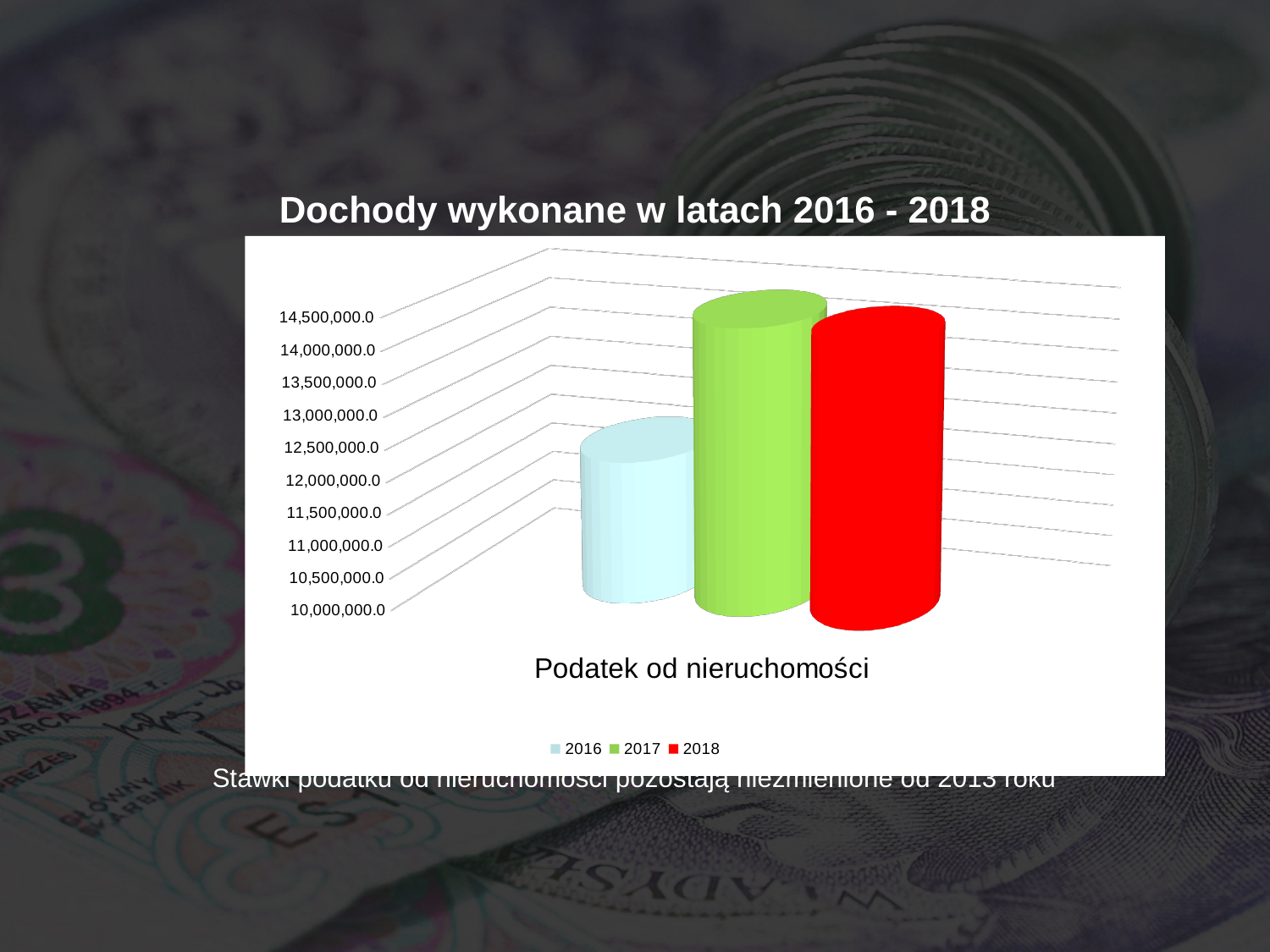
Is the value for 2018 greater or less than 12,500,000.0? greater Is the value for 2016 greater or less than 11,000,000.0? greater How many categories are shown on the x axis? 1 Which year has the lowest value for Podatek od nieruchomości? 2016 Which series is shown in red in the legend? 2018 Which is larger for Podatek od nieruchomości, the value for 2018 or the value for 2016? 2018 What kind of chart is shown on the slide? bar chart Is the value for 2017 greater or less than 13,000,000.0? greater Which is larger for Podatek od nieruchomości, the value for 2016 or the value for 2017? 2017 How many series does the legend list? 3 What is the title of the chart? Dochody wykonane w latach 2016 - 2018